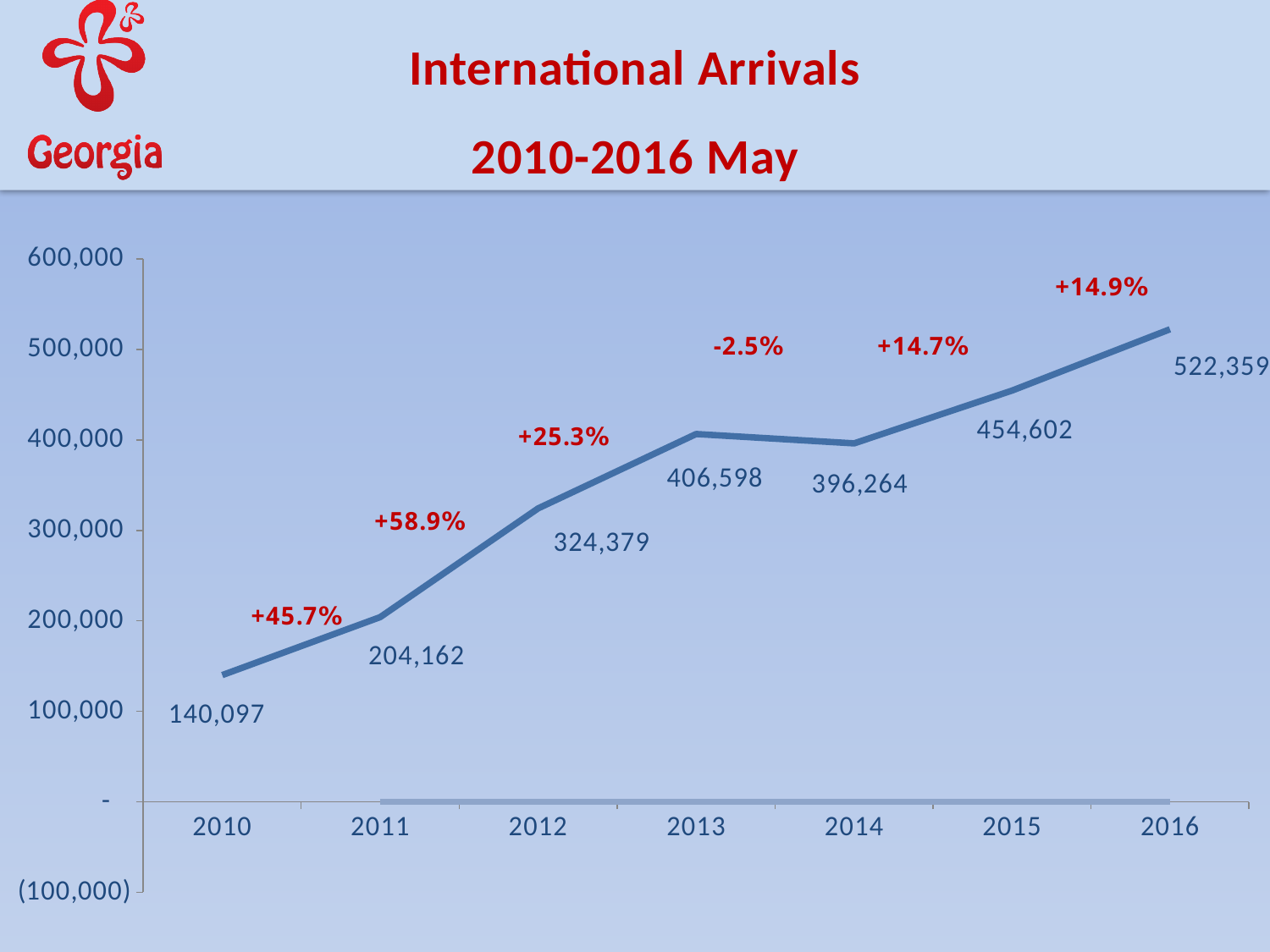
Which year has the lowest number of international arrivals? 2010 What is the value of international arrivals for 2016? 522,359 Which year has the highest number of international arrivals? 2016 What is the value of international arrivals for 2013? 406,598 What percentage change is shown between 2013 and 2014? -2.5% Is the value for 2012 greater or less than 300,000? greater What kind of chart is shown on the slide? Line chart Which year had more international arrivals, 2013 or 2014? 2013 What is the value of international arrivals for 2010? 140,097 What is the title of the chart? International Arrivals 2010-2016 May How many years are plotted on the chart? 7 What is the difference in international arrivals between 2016 and 2015? 67,757